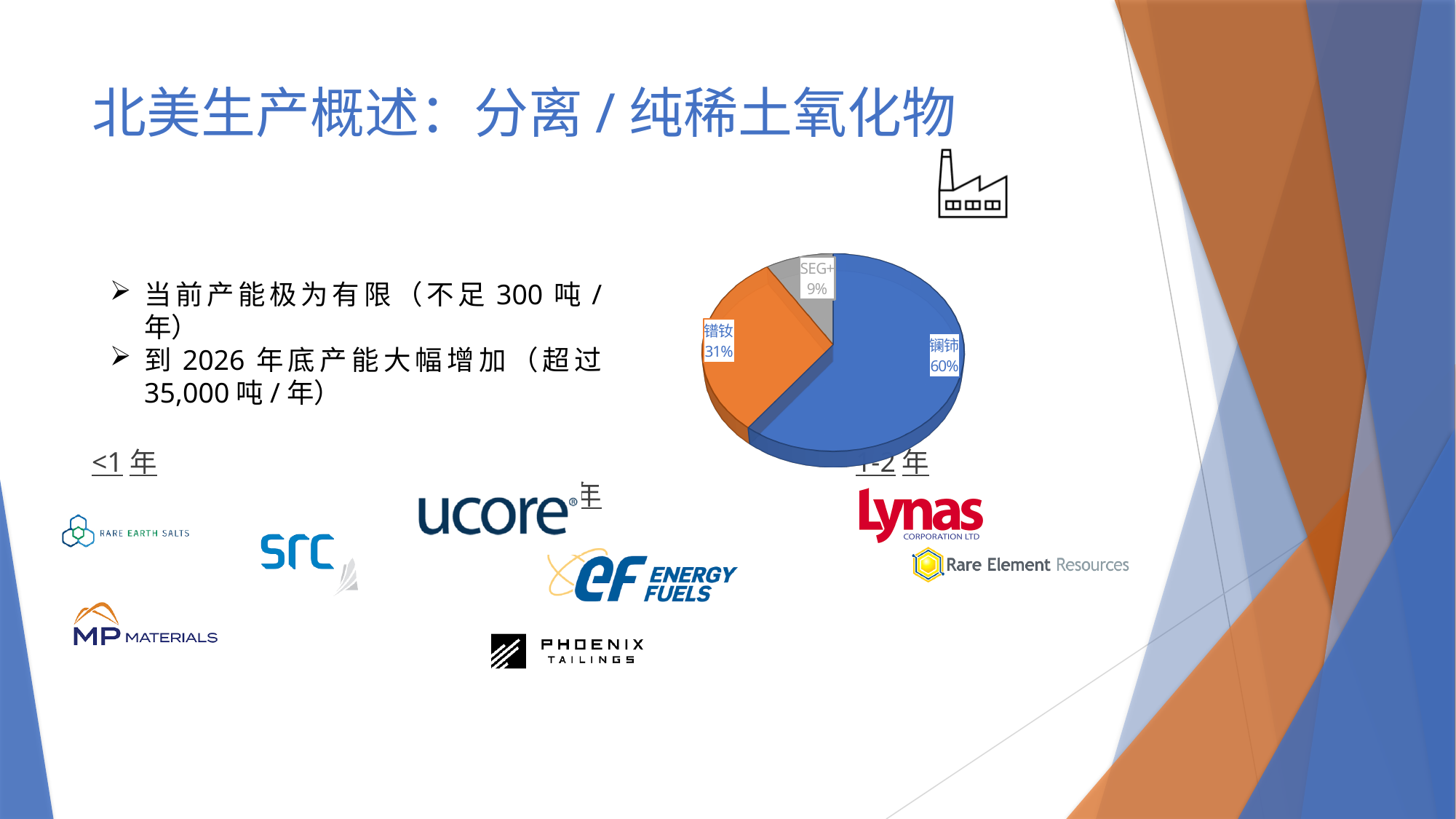
What share of the pie does 镨钕 represent? 31% Which is larger in the pie chart, 镨钕 or SEG+? 镨钕 What is the difference in percentage points between the 镧铈 slice and the 镨钕 slice? 29 What share of the pie does 镧铈 represent? 60% What colour is the 镧铈 slice in the pie chart? blue What share of the pie does SEG+ represent? 9% How many slices does the pie chart have? 3 What is the difference in percentage points between the 镨钕 slice and the SEG+ slice? 22 Which slice of the pie chart is the smallest? SEG+ What kind of chart is shown on the slide? pie chart What colour is the 镨钕 slice in the pie chart? orange Which slice of the pie chart is the largest? 镧铈